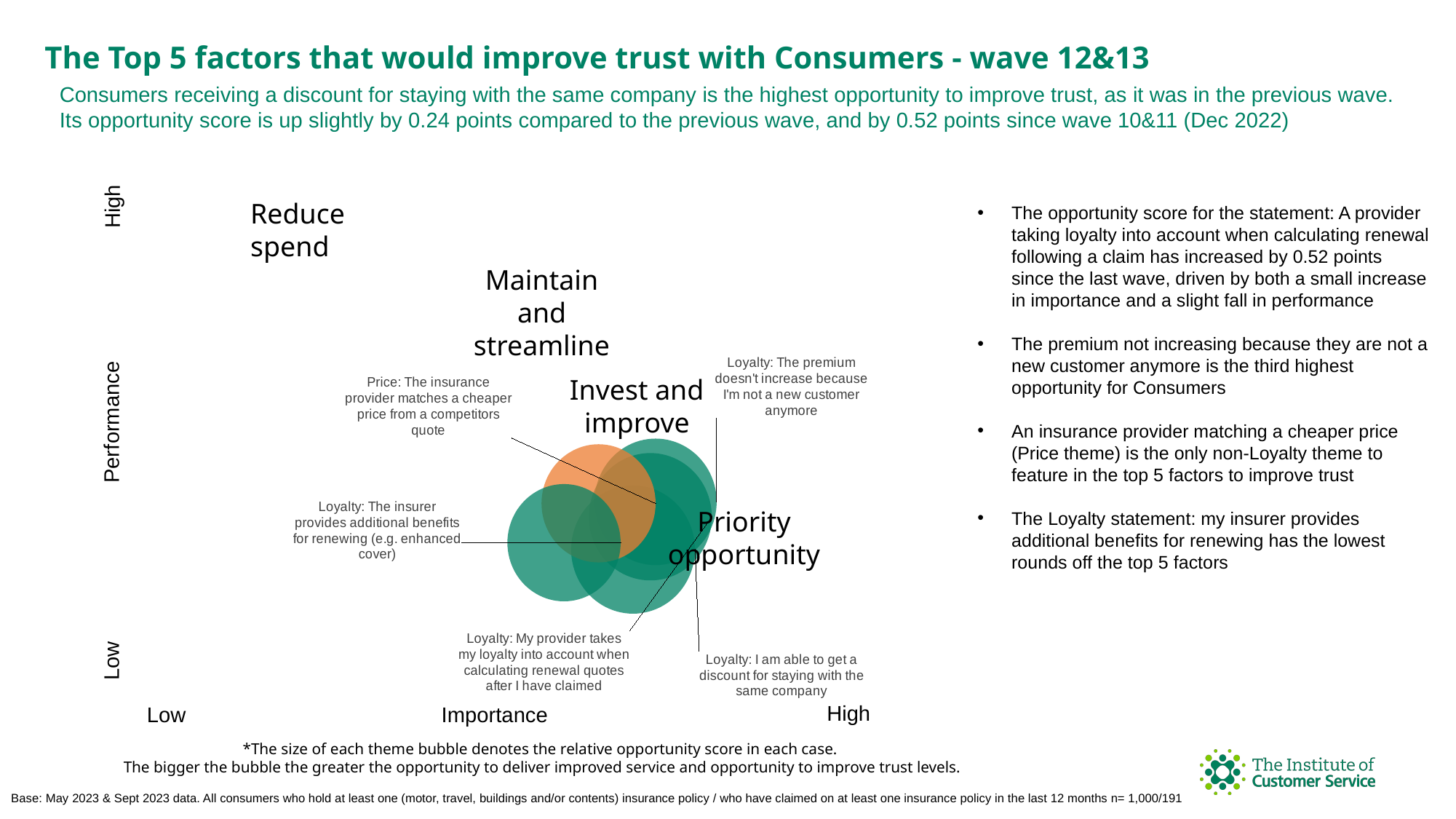
Which quadrant label appears in the top-left corner of the chart? Reduce spend How many of the five plotted factors belong to the Loyalty theme? 4 How many factor bubbles are plotted on the chart? 5 What is the label of the horizontal axis of the chart? Importance Which plotted factor is the only one from the Price theme rather than the Loyalty theme? Price: The insurance provider matches a cheaper price from a competitors quote Which factor's bubble is coloured orange rather than green? Price: The insurance provider matches a cheaper price from a competitors quote Which quadrant label appears in the bottom-right area of the chart? Priority opportunity According to the chart's footnote, what does the size of each bubble denote? The relative opportunity score What kind of chart is shown on the slide? Bubble chart What is the label of the vertical axis of the chart? Performance